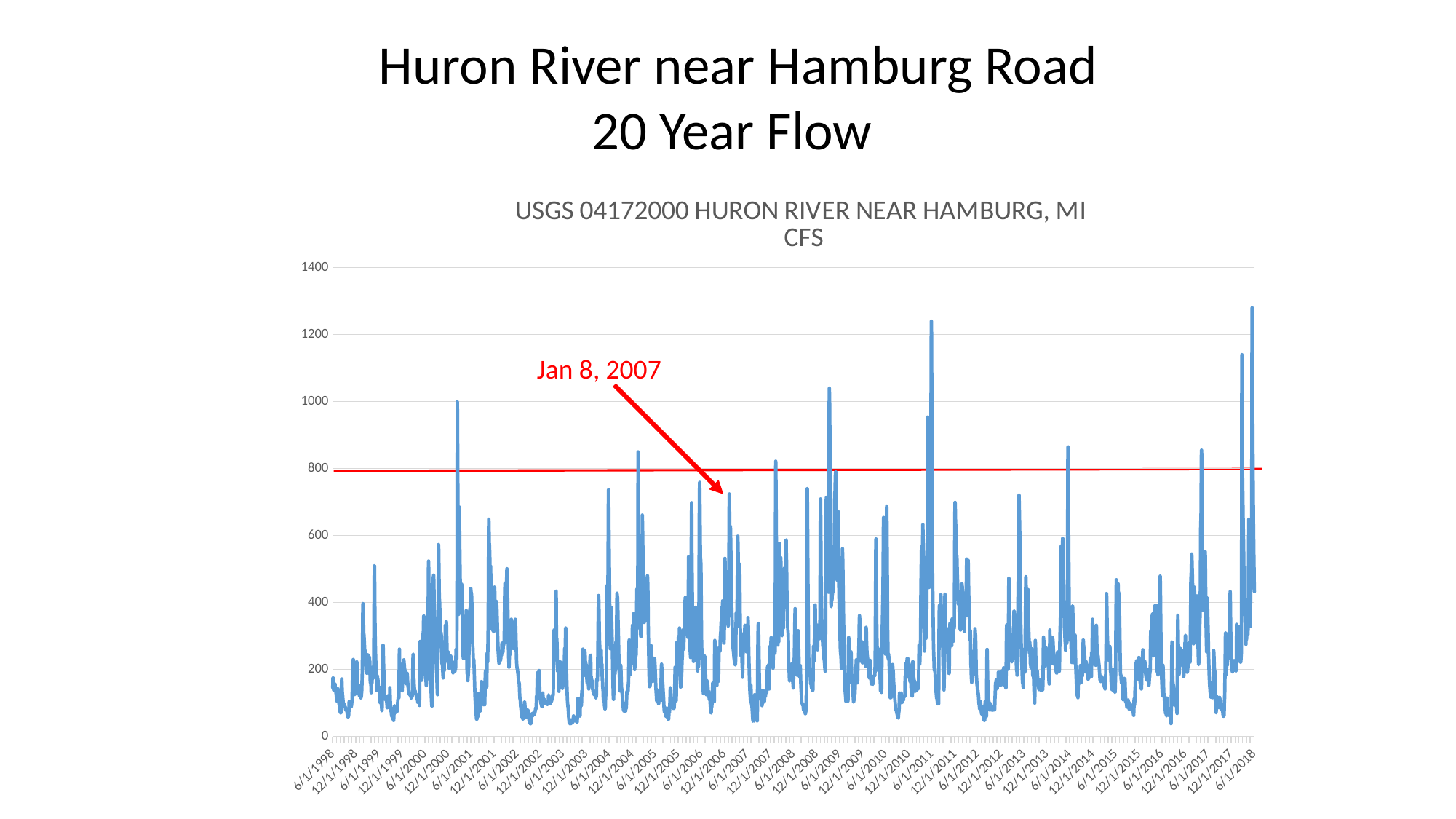
Is the red horizontal line drawn above or below the 600 gridline? above Which peak is higher, the one near 6/1/2018 or the one near 6/1/2009? 6/1/2018 What is the highest value shown on the vertical axis? 1400 What is the first date label on the horizontal axis? 6/1/1998 What kind of chart is shown on the slide? line chart Is the peak flow near 12/1/2010 greater or less than 1200? greater What date is written in the red annotation on the chart? Jan 8, 2007 Is the peak flow near 6/1/2018 greater or less than 1200? greater What is the last date label on the horizontal axis? 6/1/2018 What is the chart's title? USGS 04172000 HURON RIVER NEAR HAMBURG, MI CFS